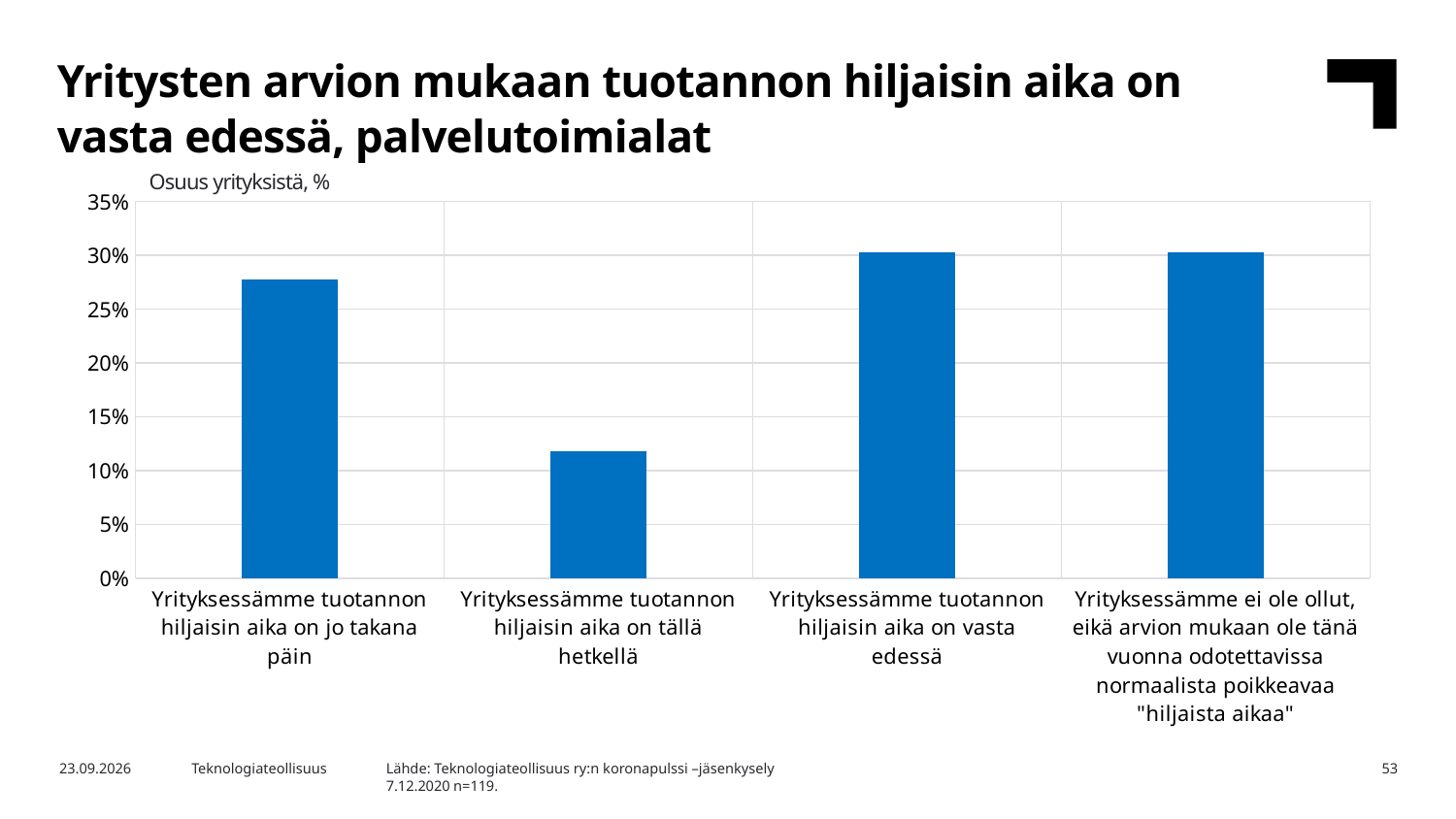
Which is larger: the value for "Yrityksessämme tuotannon hiljaisin aika on vasta edessä" or the value for "Yrityksessämme tuotannon hiljaisin aika on jo takana päin"? Yrityksessämme tuotannon hiljaisin aika on vasta edessä What kind of chart is shown on the slide? bar chart Is the value for "Yrityksessämme tuotannon hiljaisin aika on vasta edessä" greater or less than 25%? greater Which category has the lowest value in the chart? Yrityksessämme tuotannon hiljaisin aika on tällä hetkellä Is the value for "Yrityksessämme tuotannon hiljaisin aika on jo takana päin" greater or less than 30%? less How many categories are shown on the x axis of the chart? 4 Is the value for "Yrityksessämme tuotannon hiljaisin aika on tällä hetkellä" greater or less than 10%? greater Which is larger: the value for "Yrityksessämme tuotannon hiljaisin aika on jo takana päin" or the value for "Yrityksessämme tuotannon hiljaisin aika on tällä hetkellä"? Yrityksessämme tuotannon hiljaisin aika on jo takana päin What is the highest value shown on the vertical axis of the chart? 35% What is the label shown above the vertical axis of the chart? Osuus yrityksistä, %